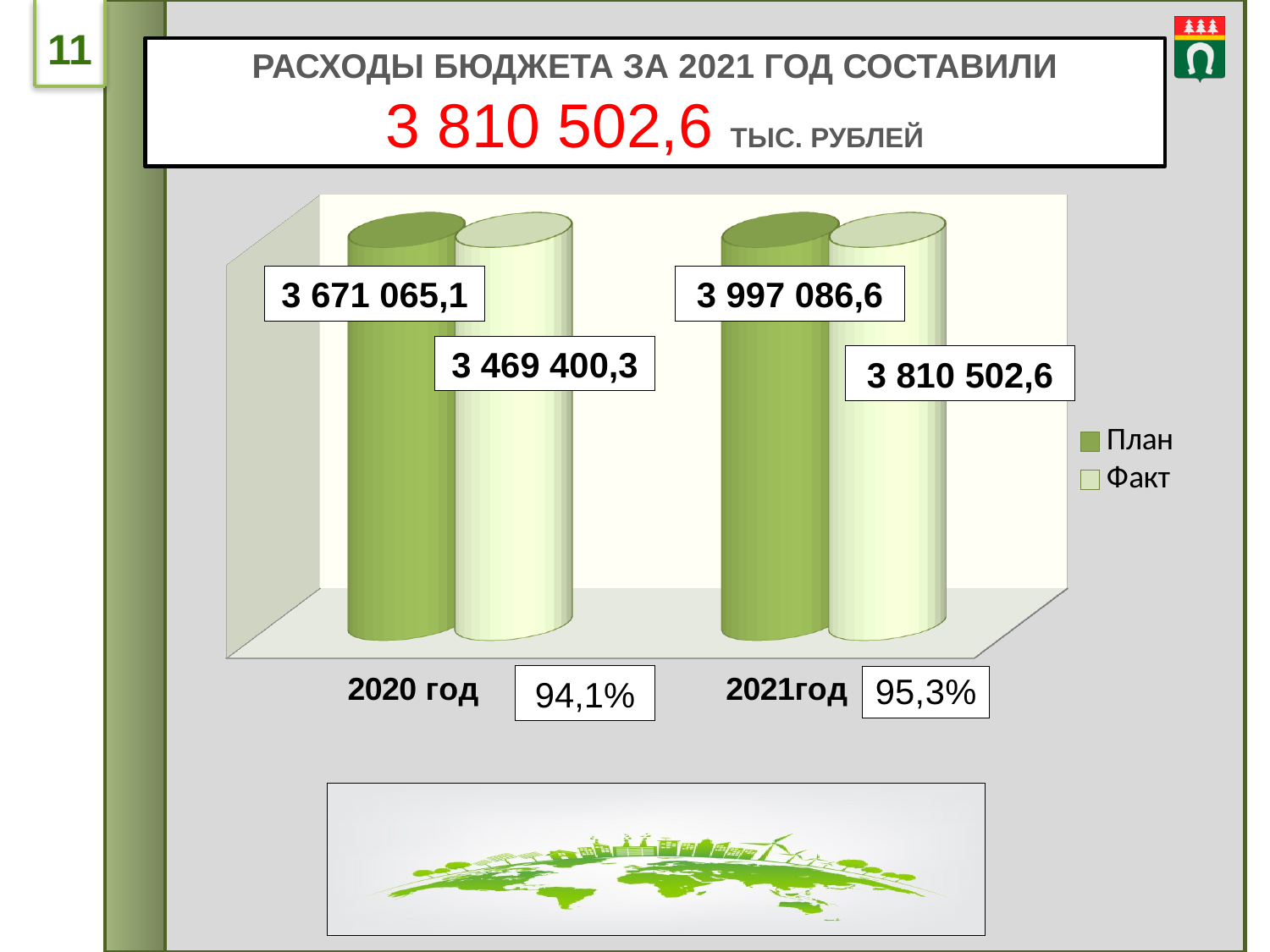
How many series does the legend list? 2 What percentage is shown next to 2021год below the chart? 95,3% Which year has the higher План value? 2021год By how much did the Факт value increase from 2020 год to 2021год? 341 102,3 What is the difference between the План and Факт values for 2021год? 186 584,0 What is the План value for 2021год? 3 997 086,6 Is the Факт value for 2020 год larger or smaller than the План value for 2020 год? smaller What is the Факт value for 2021год? 3 810 502,6 Which bar has the lowest value on the chart? Факт for 2020 год What is the План value for 2020 год? 3 671 065,1 What type of chart is shown on the slide? bar chart What is the Факт value for 2020 год? 3 469 400,3